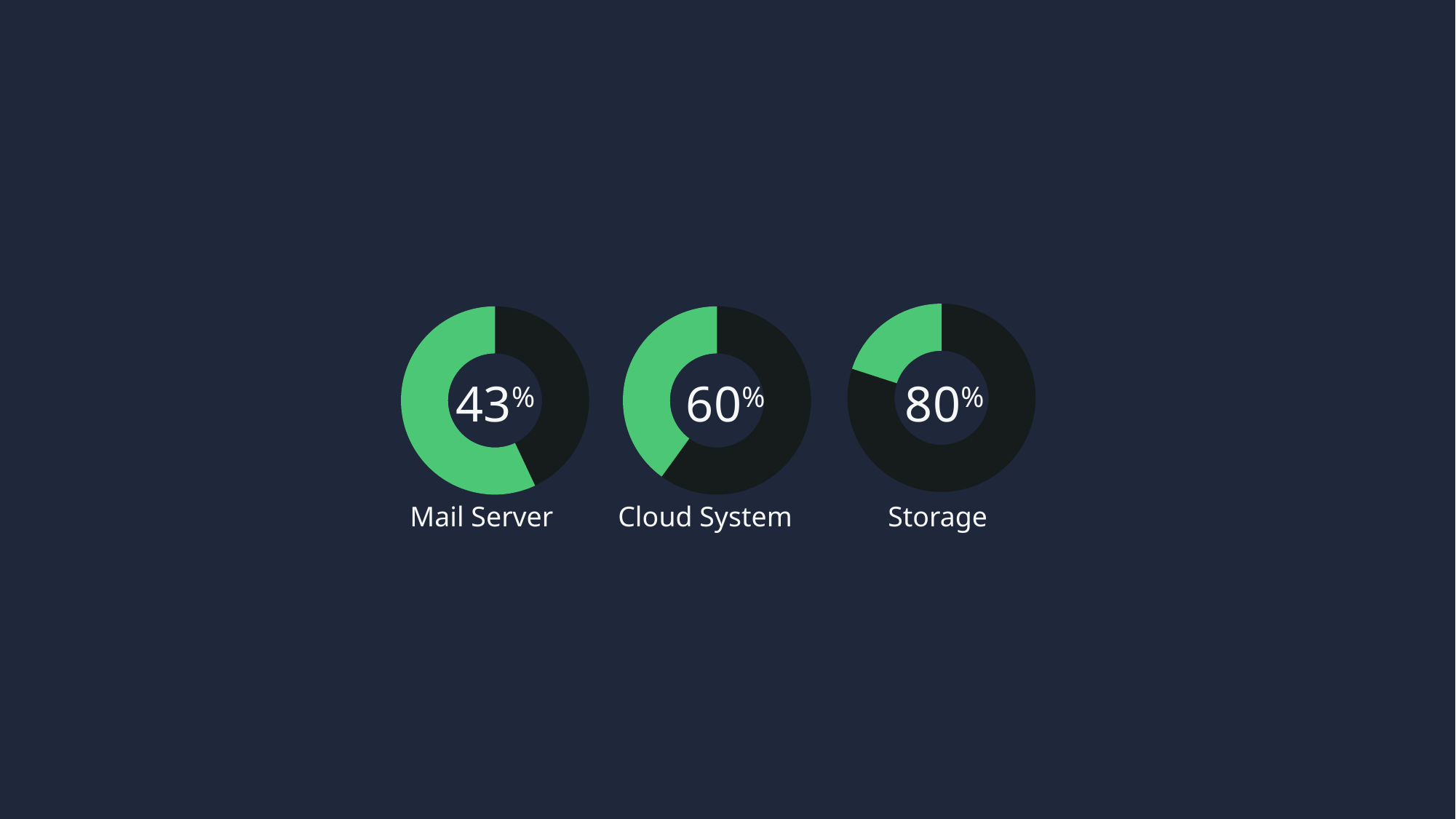
How many donut charts are on the slide? 3 What is the difference between the Storage percentage and the Mail Server percentage? 37% What percentage is shown in the Storage chart? 80% What colour is the highlighted segment in each donut chart? Green What percentage is shown in the Mail Server chart? 43% Which shows a larger percentage, Cloud System or Mail Server? Cloud System What is the difference between the Storage percentage and the Cloud System percentage? 20% What percentage is shown in the Cloud System chart? 60% What kind of chart is used for Mail Server, Cloud System and Storage? Donut (pie) chart Which of the three charts shows the lowest percentage? Mail Server Which of the three charts shows the highest percentage? Storage What is the difference between the Cloud System percentage and the Mail Server percentage? 17%